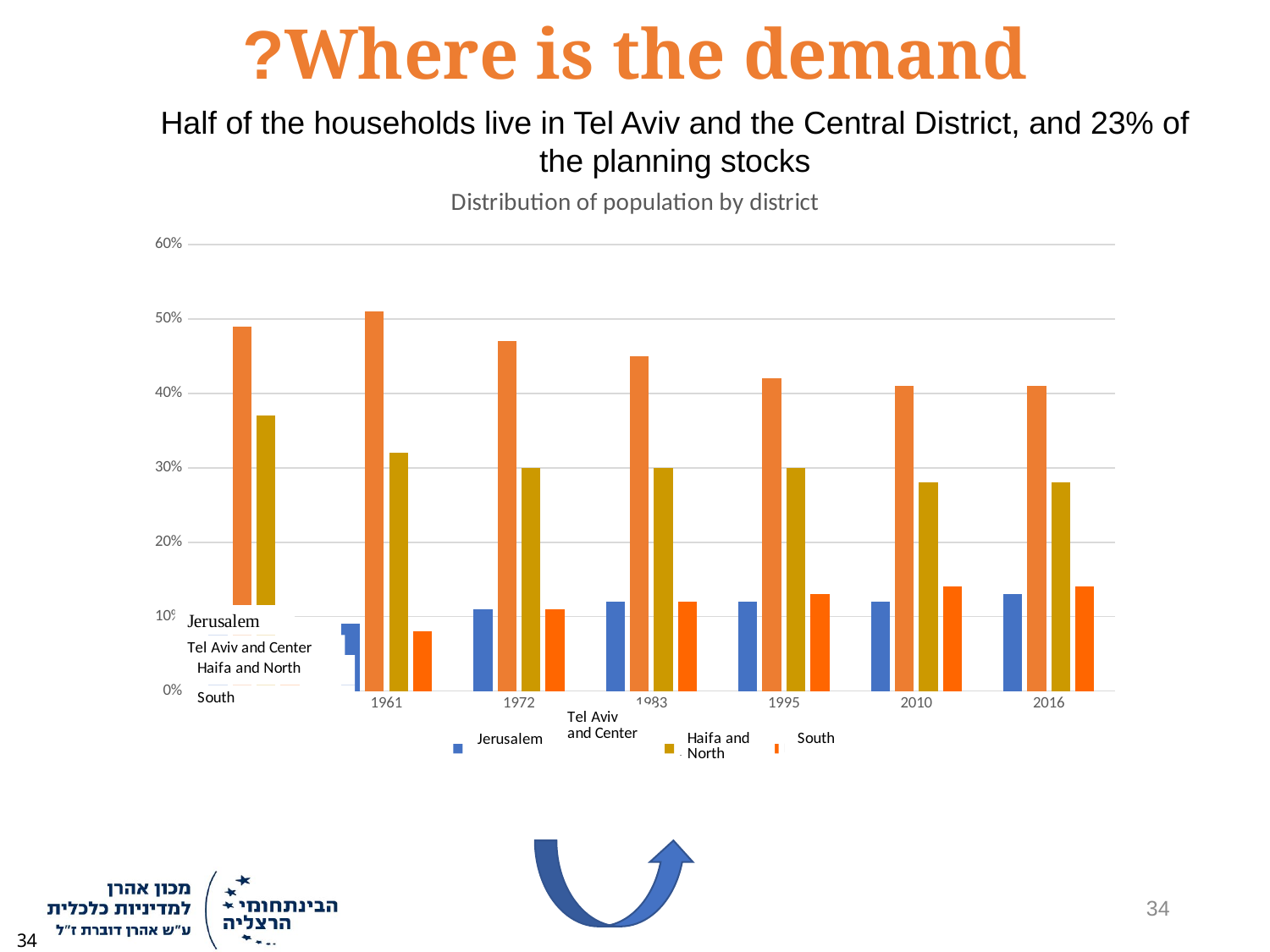
Which is larger: the Tel Aviv and Center share in 1961 or in 2016? 1961 Is the value for Tel Aviv and Center in 2016 greater or less than 50%? less Is the value for Haifa and North in 2016 greater or less than 30%? less Is the value for Tel Aviv and Center in 1961 greater or less than 50%? greater How many series does the chart's legend list? 4 Does the share for Tel Aviv and Center rise or fall from 1961 to 2016? Fall Which district has the highest share of population in 1961? Tel Aviv and Center What type of chart is shown on the slide? Bar chart What is the title of the chart? Distribution of population by district Which district has the highest share of population in 2016? Tel Aviv and Center Which series is listed second in the chart's legend? Tel Aviv and Center